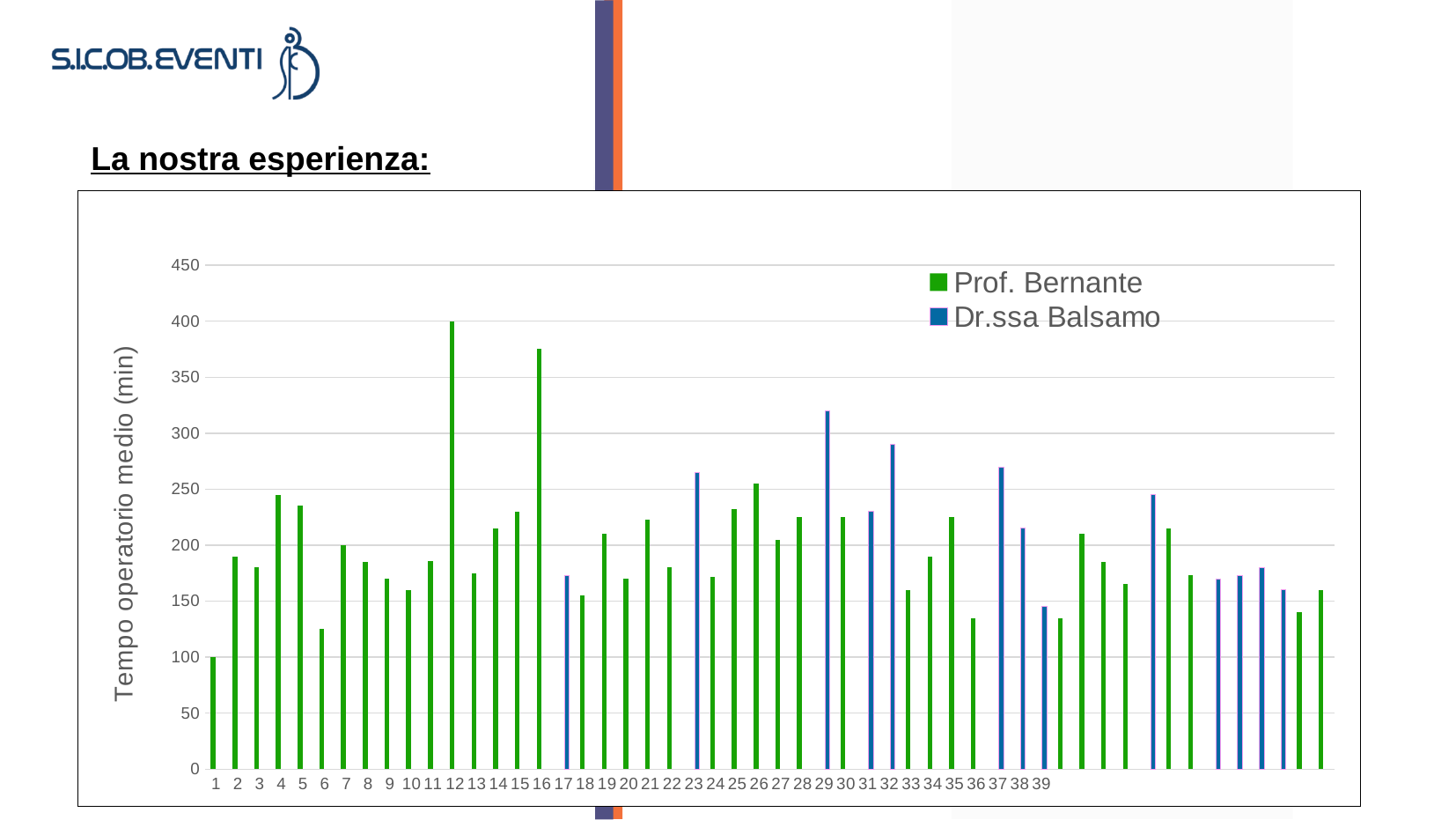
What is the value for case 1 (Prof. Bernante)? 100 What kind of chart is shown on the slide? bar chart Which case number has the lowest value for Prof. Bernante? 1 Which is larger, the value for case 29 or the value for case 32? case 29 Which case number has the highest value for Dr.ssa Balsamo? 29 Is the value for case 16 greater or less than 350? greater Is the value for case 6 greater or less than 150? less Which case number has the highest value for Prof. Bernante? 12 How many series does the legend list? 2 Which series is shown in green? Prof. Bernante What is the title of the vertical axis? Tempo operatorio medio (min) What is the value for case 12 (Prof. Bernante)? 400